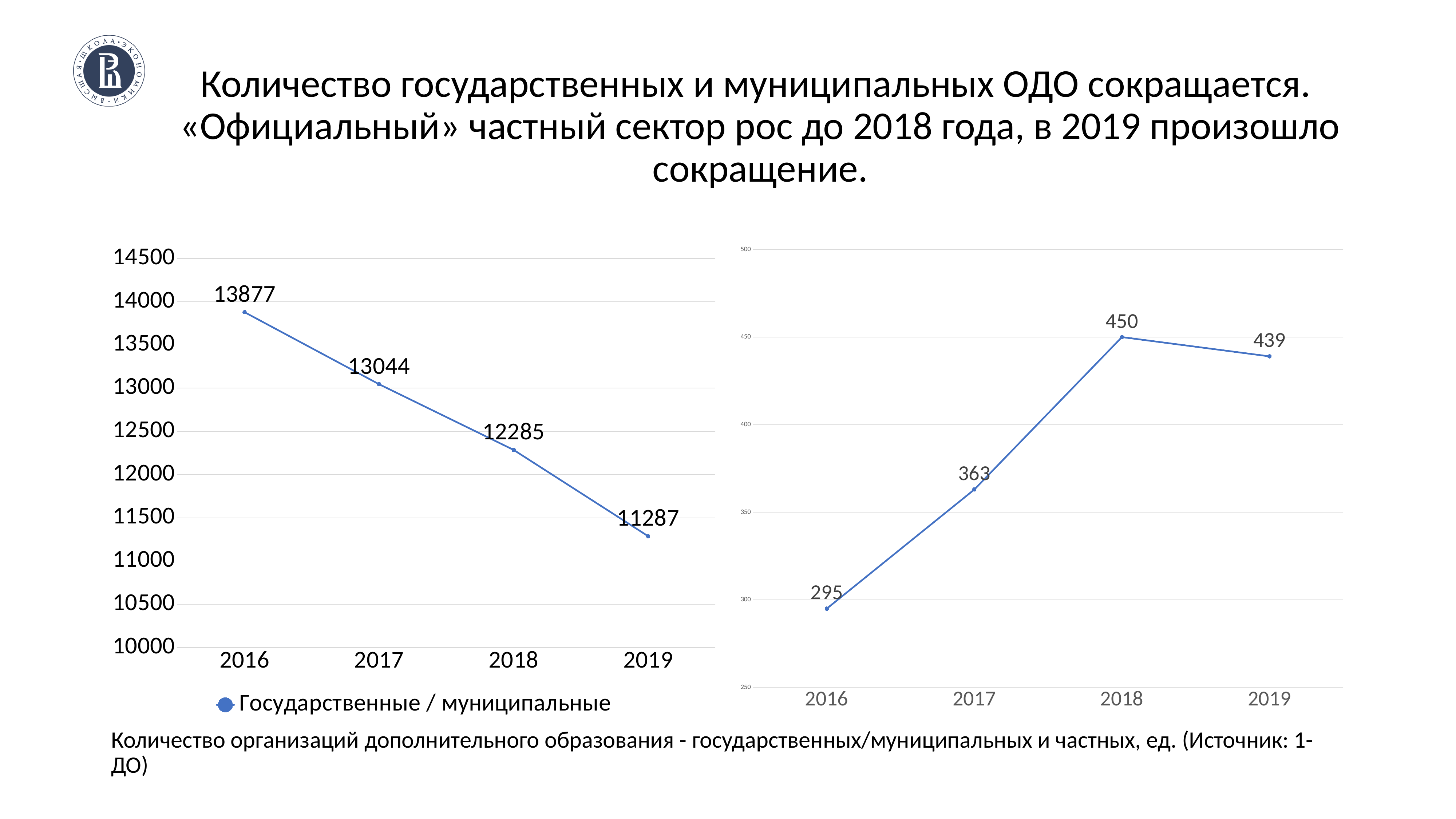
On the right chart, which is larger, the value for 2017 or the value for 2019? 2019 On the left chart, do the values rise or fall from 2016 to 2019? fall On the left chart, what is the value for 2019? 11287 On the right chart, what is the value for 2018? 450 On the left chart, what is the difference between the 2016 and 2017 values? 833 On the right chart, what is the value for 2016? 295 On the left chart, what is the value for 2016? 13877 On the left chart, which year has the lowest value? 2019 On the right chart, which year has the highest value? 2018 On the right chart, what is the difference between the 2018 and 2019 values? 11 What kind of chart is the left chart? line chart How many years are plotted on the left chart? 4